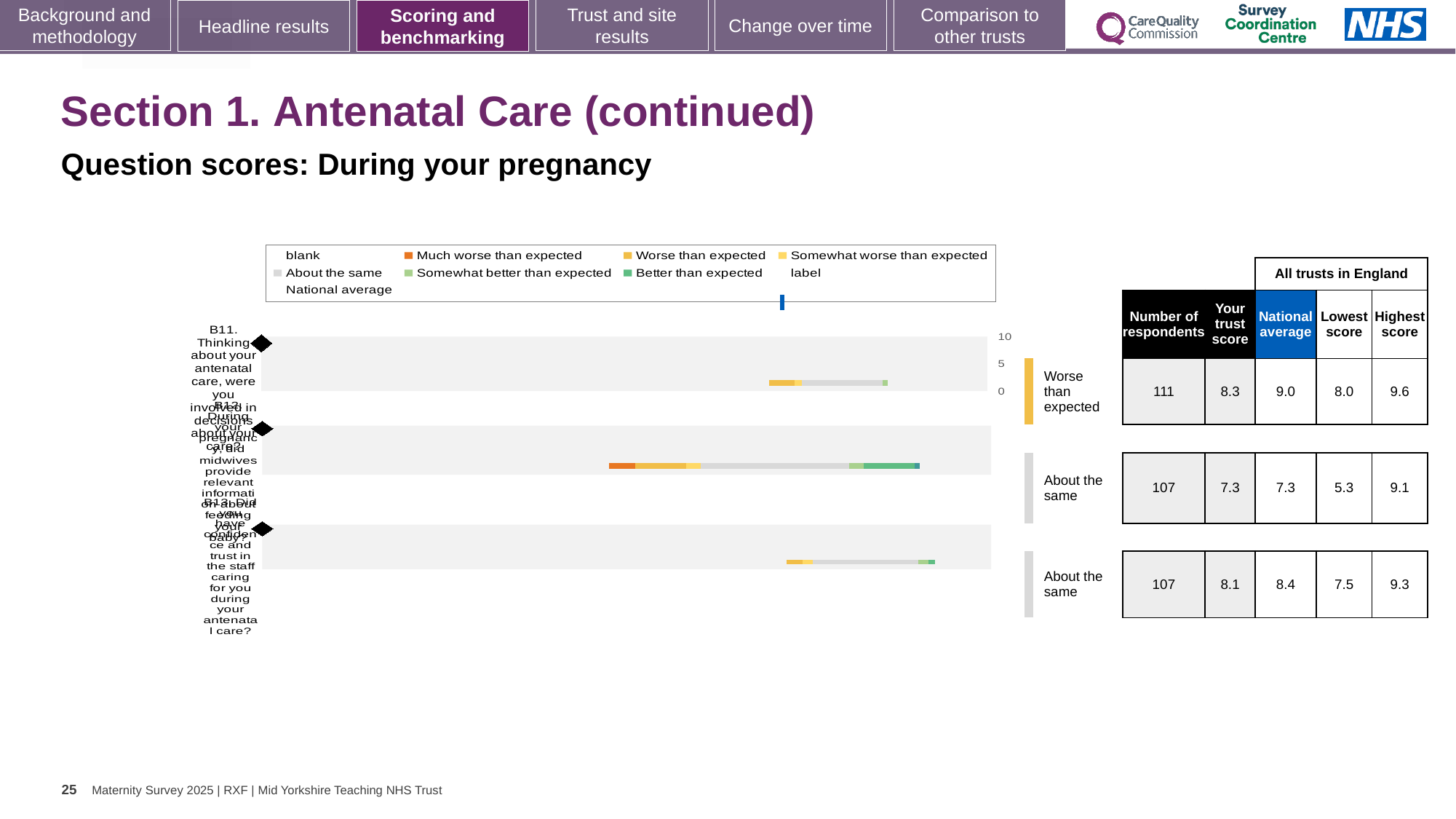
Which row has the highest value in the 'Highest score' column? the first row (B11), 9.6 In the table, what is the trust score for the first row (B11)? 8.3 How many question rows (categories) are plotted in the chart? 3 What colour does the legend use for 'Much worse than expected'? orange In the table, what is the national average for the second row (B12)? 7.3 Which row has the lowest value in the 'Lowest score' column? the second row (B12), 5.3 What kind of chart is shown on the slide? bar chart In the table, what is the number of respondents for the first row (B11)? 111 What is the difference between the national average and the trust score for the first row (B11)? 0.7 In the table, what is the lowest score for the third row (B13)? 7.5 What benchmark label is shown next to the first row (B11)? Worse than expected For the third row (B13), which is larger: the trust score or the national average? the national average (8.4)